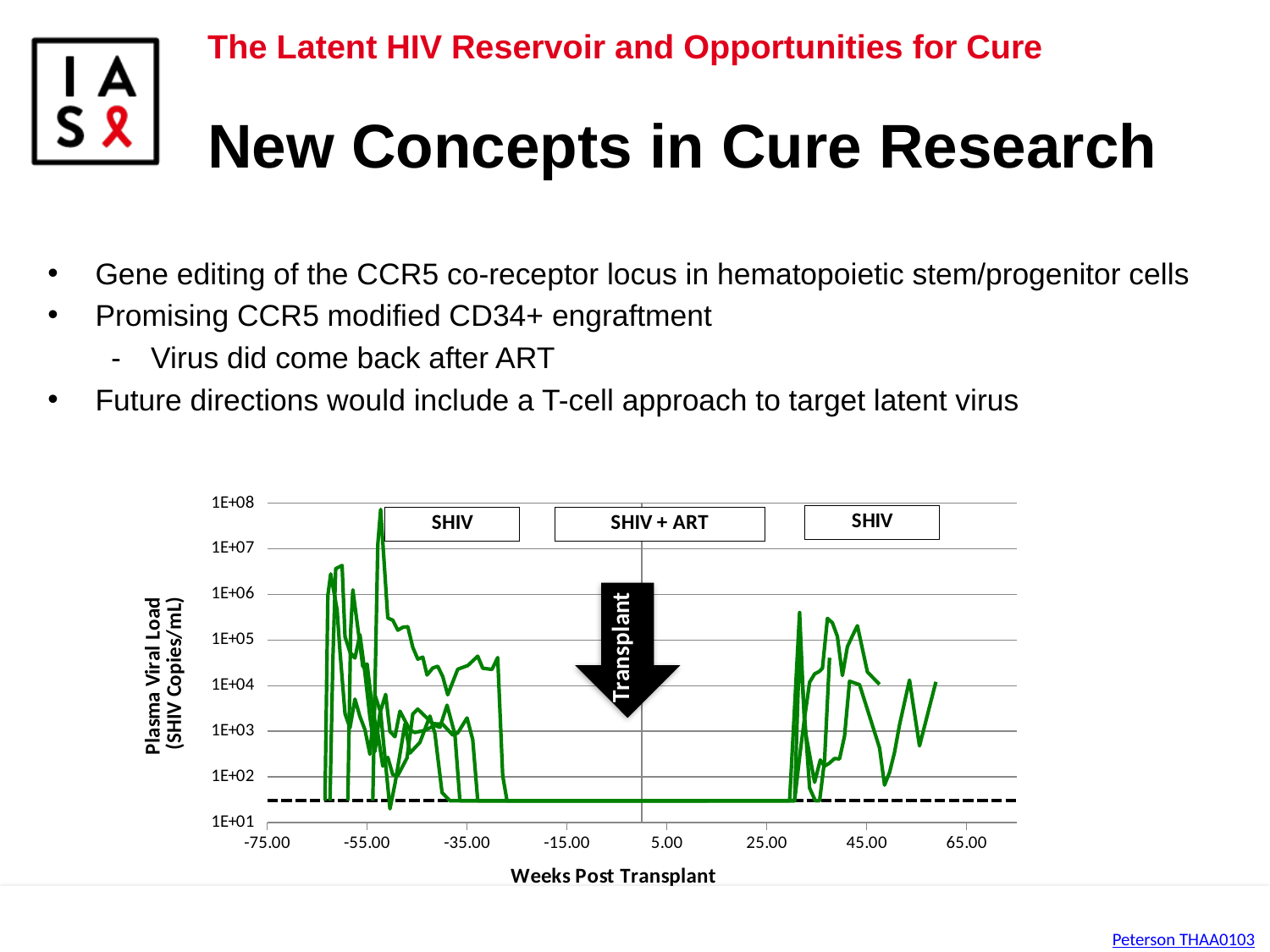
Between week -15.00 and week 25.00, do the plotted viral load values rise, fall, or stay flat? stay flat What label is shown in the middle box above the plotted lines, between the two SHIV boxes? SHIV + ART Is the level of the dashed horizontal line greater or less than 1E+02? less How many tick labels are shown on the x axis of the chart? 8 What is the rightmost tick value on the x axis of the chart? 65.00 What is the leftmost tick value on the x axis of the chart? -75.00 What is the title of the x axis of the chart? Weeks Post Transplant What kind of chart is shown on the slide? line chart What is the lowest tick value shown on the y axis of the chart? 1E+01 What is the highest tick value shown on the y axis of the chart? 1E+08 Is the highest peak of plasma viral load before transplant greater or less than 1E+06? greater During the SHIV + ART period, around week 5.00, is the plasma viral load greater or less than 1E+03? less